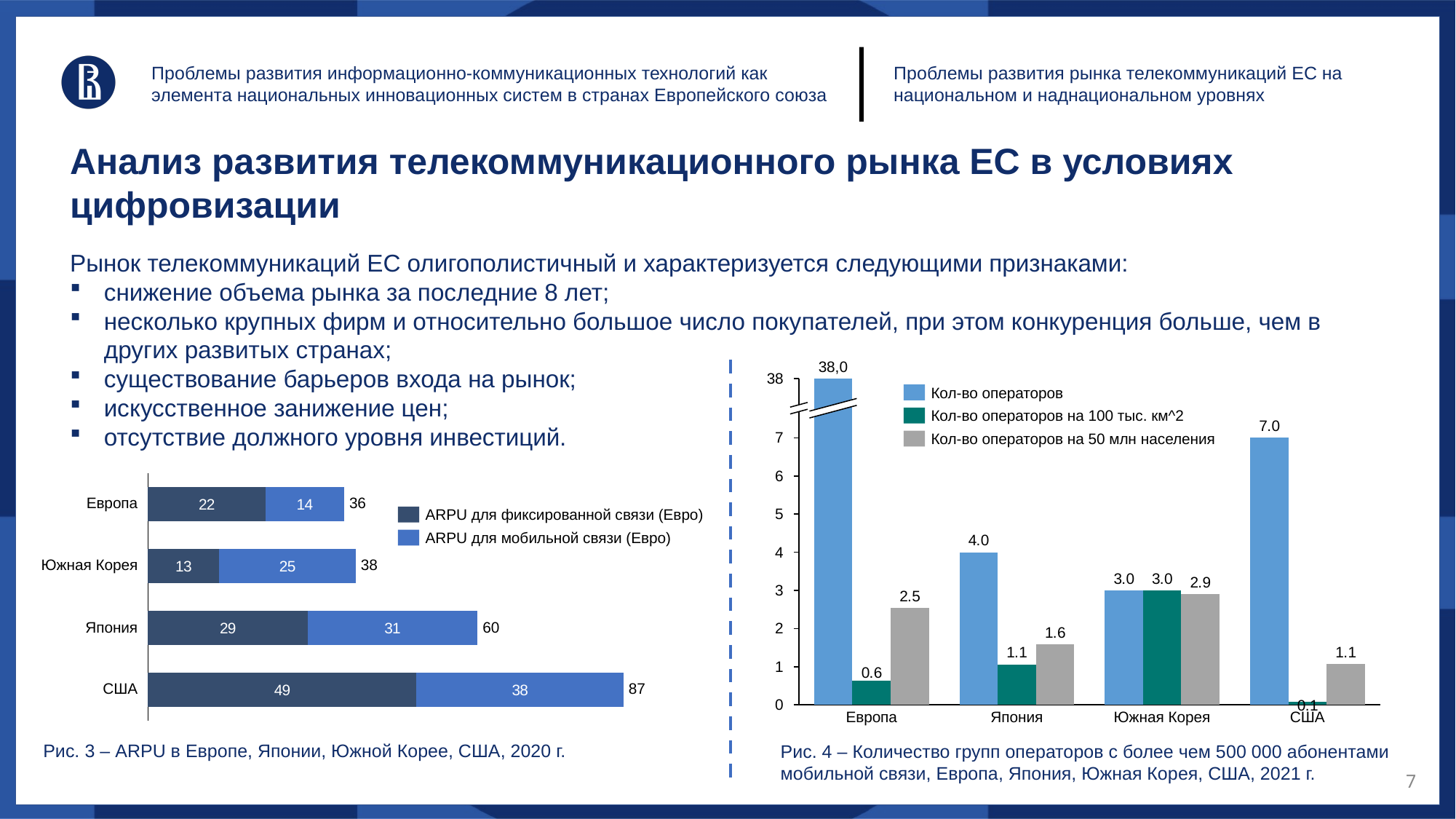
In the right chart (Рис. 4), which country has the lowest value of Кол-во операторов на 50 млн населения? США In the left chart (Рис. 3), what is the ARPU for mobile communication (ARPU для мобильной связи) for Южная Корея? 25 In the right chart (Рис. 4), which is larger: Кол-во операторов for Япония or for США? США In the right chart (Рис. 4), what is the value of Кол-во операторов на 100 тыс. км^2 for США? 0.1 In the left chart (Рис. 3), what is the difference between the fixed-line ARPU and the mobile ARPU for Европа? 8 In the left chart (Рис. 3), what is the ARPU for fixed-line communication (ARPU для фиксированной связи) for США? 49 In the left chart (Рис. 3), what is the total ARPU shown for Япония? 60 What type of chart is the right chart (Рис. 4)? Bar chart In the right chart (Рис. 4), what is the value of Кол-во операторов for Европа? 38,0 In the left chart (Рис. 3), which country has the highest total ARPU? США In the left chart (Рис. 3), how many series does the legend list? 2 In the right chart (Рис. 4), how many countries are shown on the x axis? 4